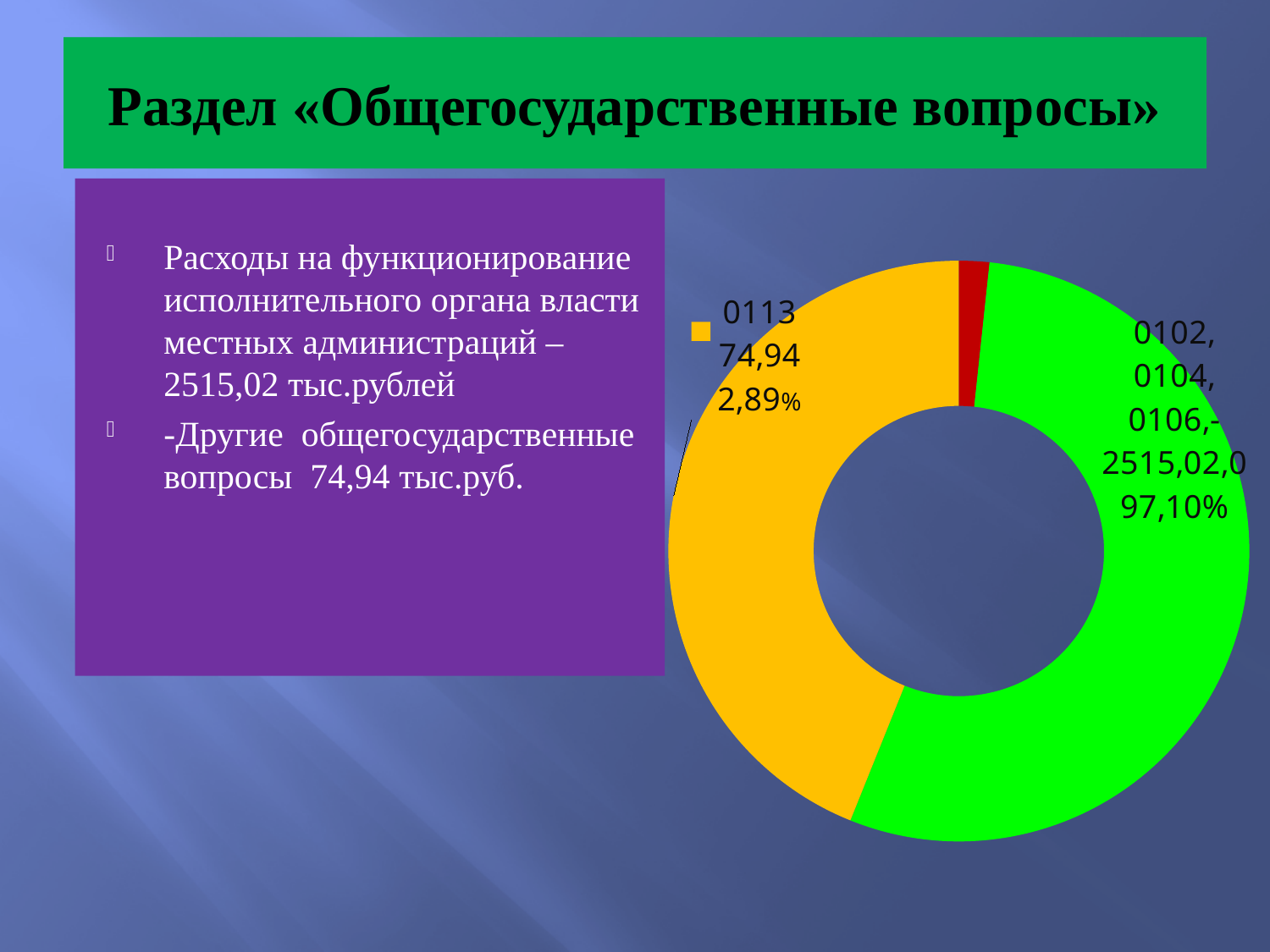
What is the difference between the printed values for 0102, 0104, 0106 and 0113? 2440,08 What value is printed for the 0113 slice? 74,94 What value is printed for the slice labelled 0102, 0104, 0106? 2515,02 What percentage share is printed for the 0113 slice? 2,89% Which has the larger printed value, 0113 or 0102, 0104, 0106? 0102, 0104, 0106 What colour is the slice labelled 0113? orange What colour is the slice labelled 0102, 0104, 0106? green What kind of chart is shown on the slide? doughnut (pie) chart What percentage share is printed for the slice labelled 0102, 0104, 0106? 97,10% Which slice has the largest printed share? 0102, 0104, 0106 How many slices does the doughnut chart have? 3